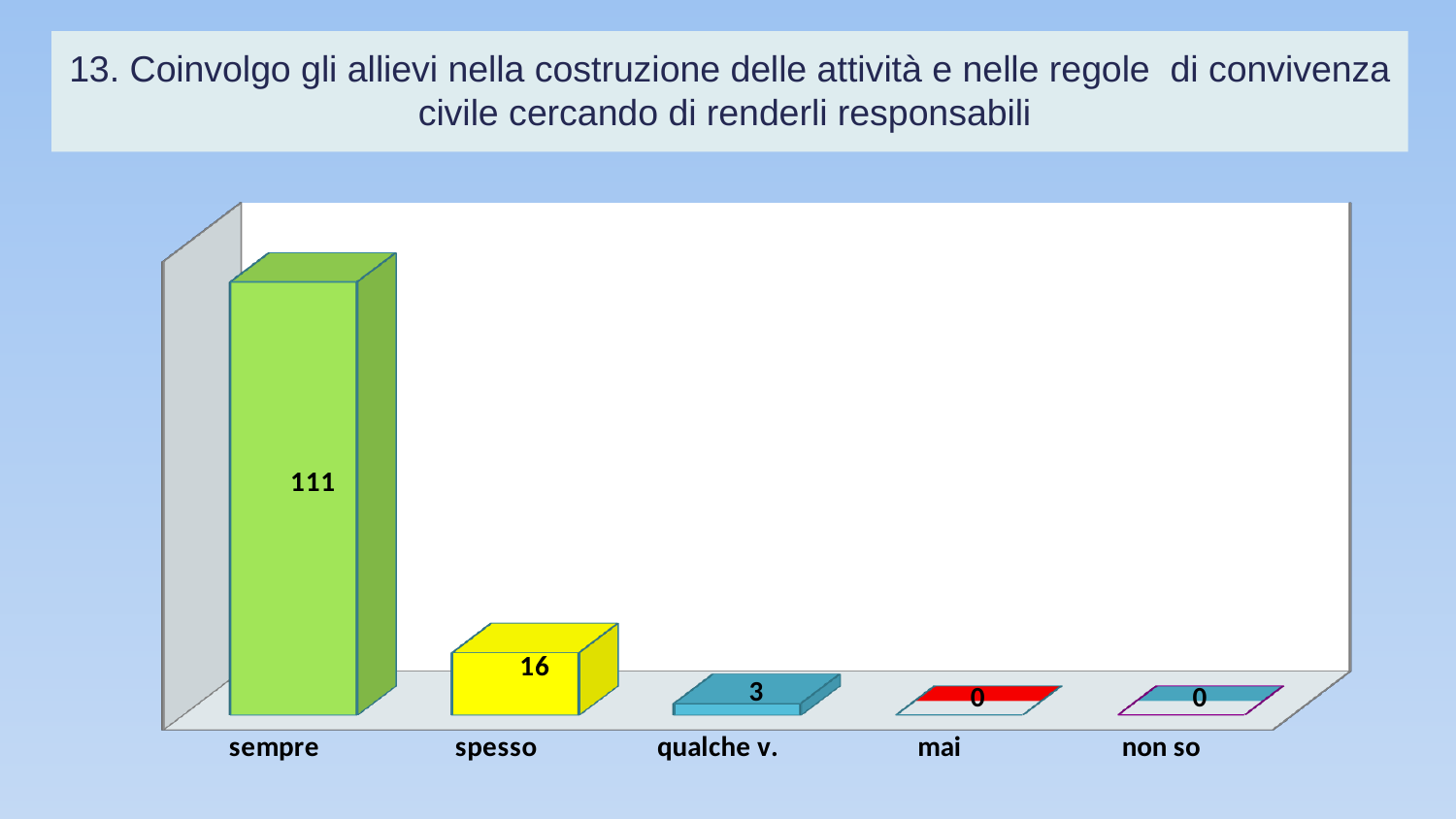
How many categories are shown on the x axis? 5 What is the value for "qualche v."? 3 Which category has the highest value? sempre Which is larger, the value for "spesso" or the value for "qualche v."? spesso What is the difference between the values for "spesso" and "qualche v."? 13 What kind of chart is shown on the slide? bar chart Do the values rise or fall from left to right along the x axis? fall What is the difference between the values for "sempre" and "spesso"? 95 What is the value for "mai"? 0 What colour is the bar for "sempre"? green What is the value for "spesso"? 16 What is the value for "sempre"? 111